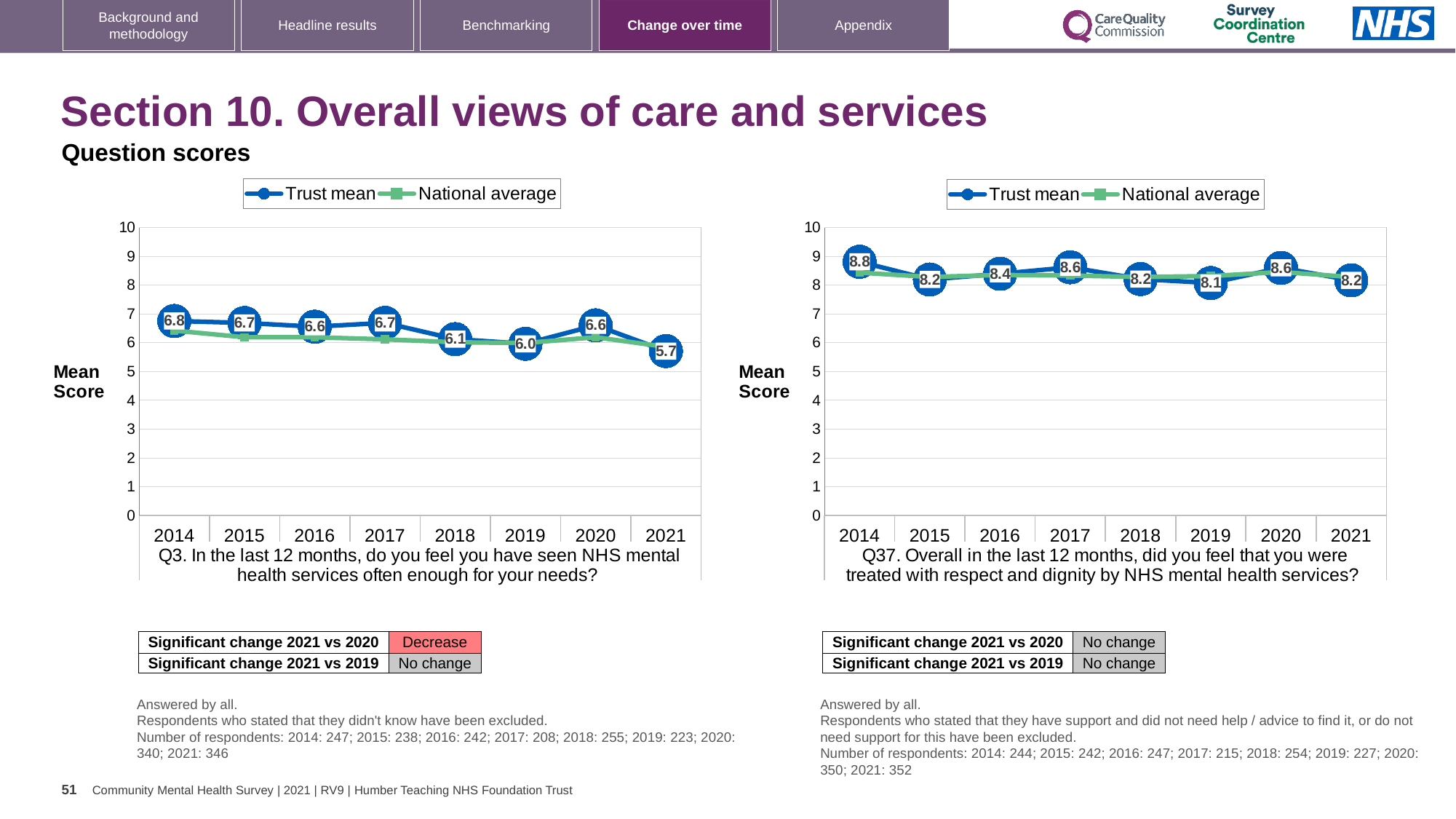
In the right chart (Q37), is the National average for 2021 greater or less than 9? less In the right chart (Q37), which year has the lowest Trust mean? 2019 In the left chart (Q3), which year has the highest Trust mean? 2014 In the right chart (Q37), which is larger, the Trust mean for 2016 or for 2017? 2017 In the left chart (Q3), is the National average for 2014 greater or less than 6? greater In the left chart (Q3), what is the Trust mean for 2021? 5.7 In the left chart (Q3), does the Trust mean rise or fall from 2020 to 2021? Fall How many series does the legend of the right chart (Q37) list? 2 What kind of chart is the left chart (Q3)? Line chart How many years are plotted on the x axis of the left chart (Q3)? 8 In the right chart (Q37), what is the Trust mean for 2014? 8.8 In the left chart (Q3), what is the difference between the Trust mean in 2020 and in 2021? 0.9